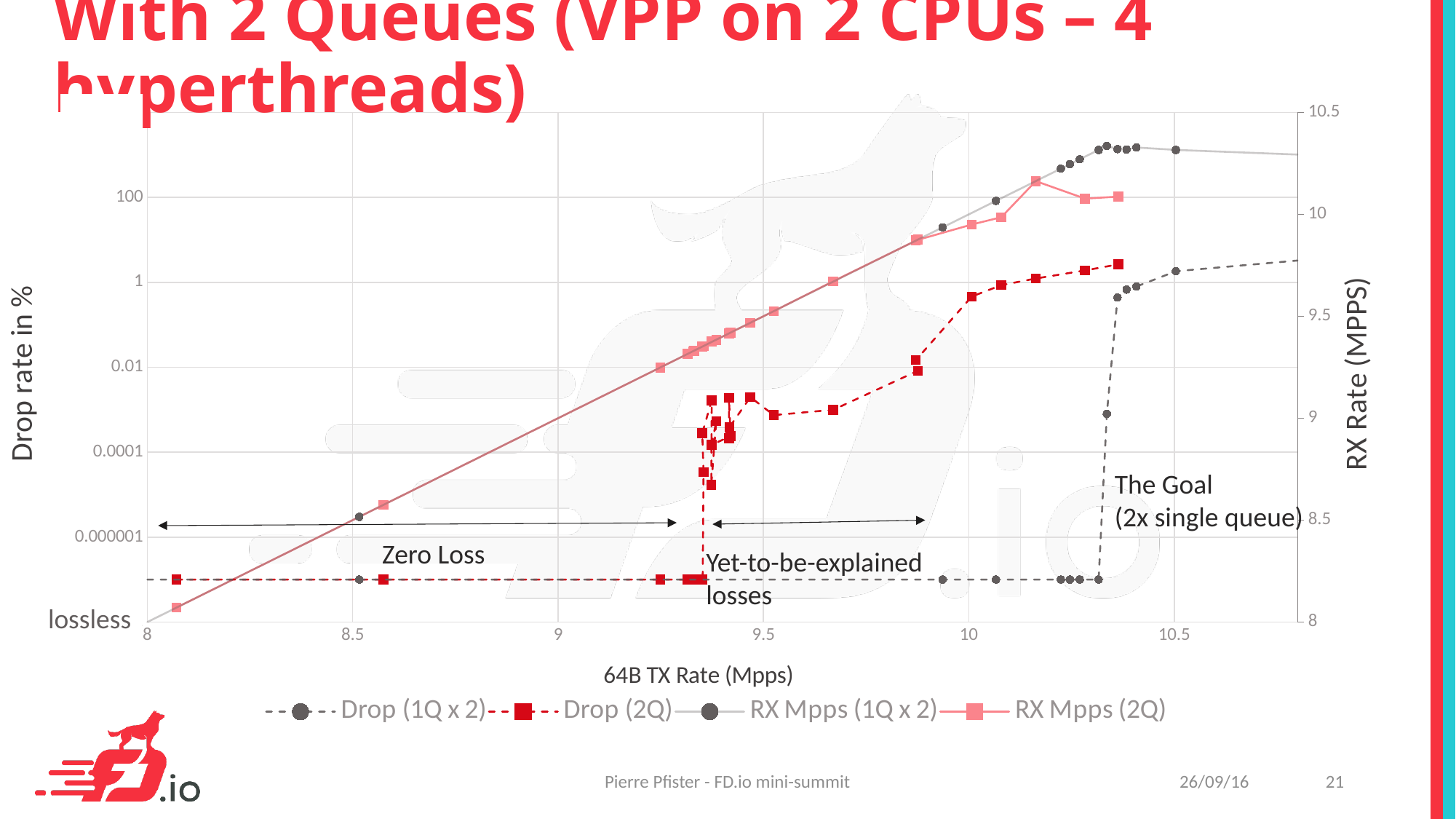
Is the RX Mpps (1Q x 2) value at a TX rate of 9.5 Mpps greater or less than 9 on the RX Rate axis? greater At a TX rate of 10 Mpps, which series shows the higher drop rate, Drop (1Q x 2) or Drop (2Q)? Drop (2Q) Is the RX Mpps (2Q) value at a TX rate of 10 Mpps greater or less than 9.5 on the RX Rate axis? greater At a TX rate of about 10.35 Mpps, which series has the higher RX rate, RX Mpps (1Q x 2) or RX Mpps (2Q)? RX Mpps (1Q x 2) Is the Drop (2Q) value at a TX rate of 10 Mpps greater or less than 0.01%? greater What kind of chart is shown on the slide? line chart Which series reaches the highest RX rate on the chart? RX Mpps (1Q x 2) Does the RX Mpps (2Q) series rise or fall as the TX rate increases from 8 to 10 Mpps? rises How many series does the chart legend list? 4 What is the title of the left y axis of the chart? Drop rate in % What is the title of the x axis of the chart? 64B TX Rate (Mpps)